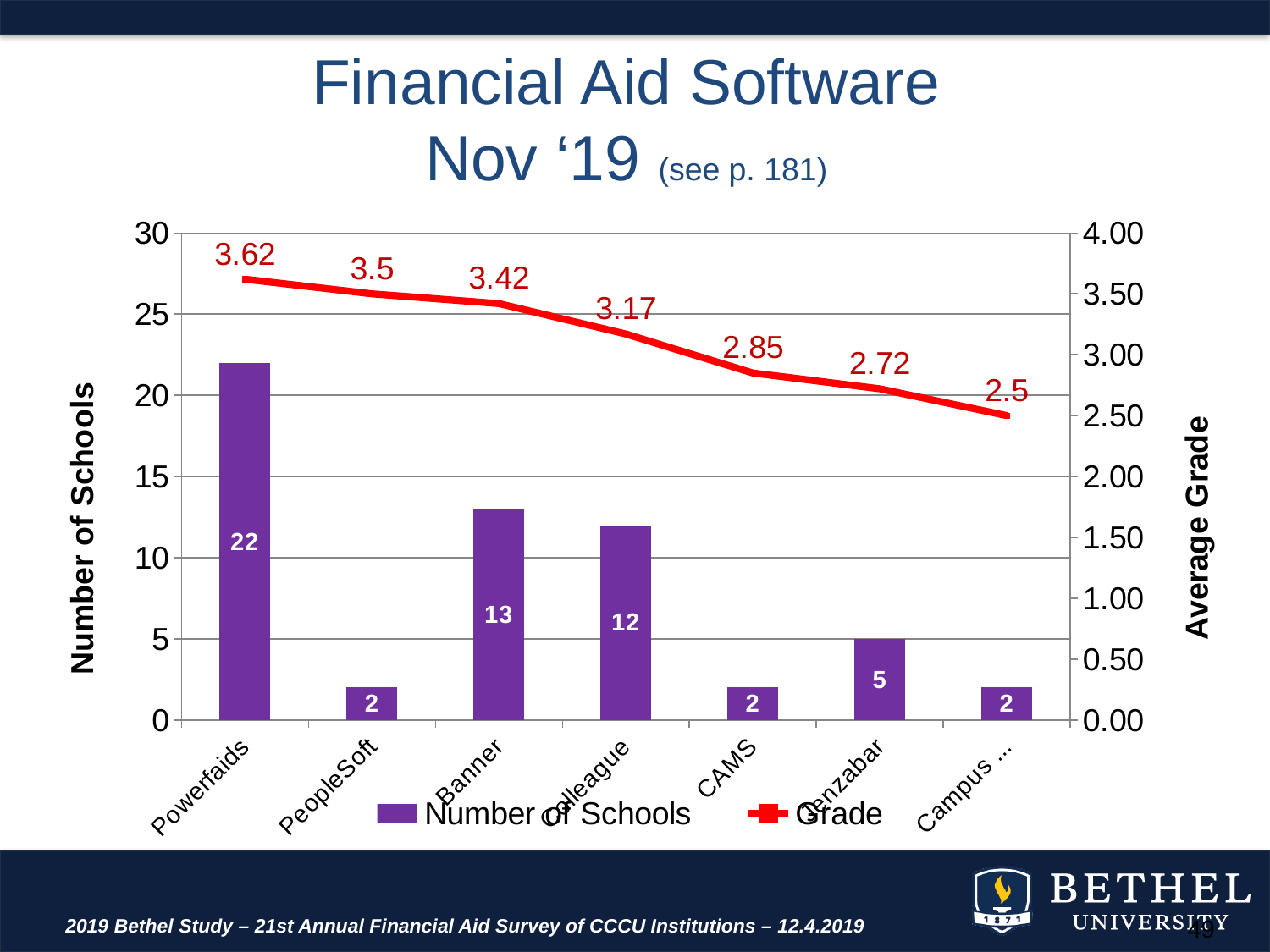
What is the difference in Grade between PeopleSoft and Jenzabar? 0.78 Which category has the highest Grade? Powerfaids What is the title of the right-hand vertical axis? Average Grade What is the Number of Schools for Powerfaids? 22 Which has a higher Number of Schools, Banner or Colleague? Banner What is the Number of Schools for Jenzabar? 5 What is the Grade for CAMS? 2.85 Which category has the highest Number of Schools? Powerfaids What is the difference in Number of Schools between Powerfaids and Banner? 9 Does the Grade line rise or fall from left to right across the categories? fall What is the Grade for Banner? 3.42 How many series does the legend list? 2